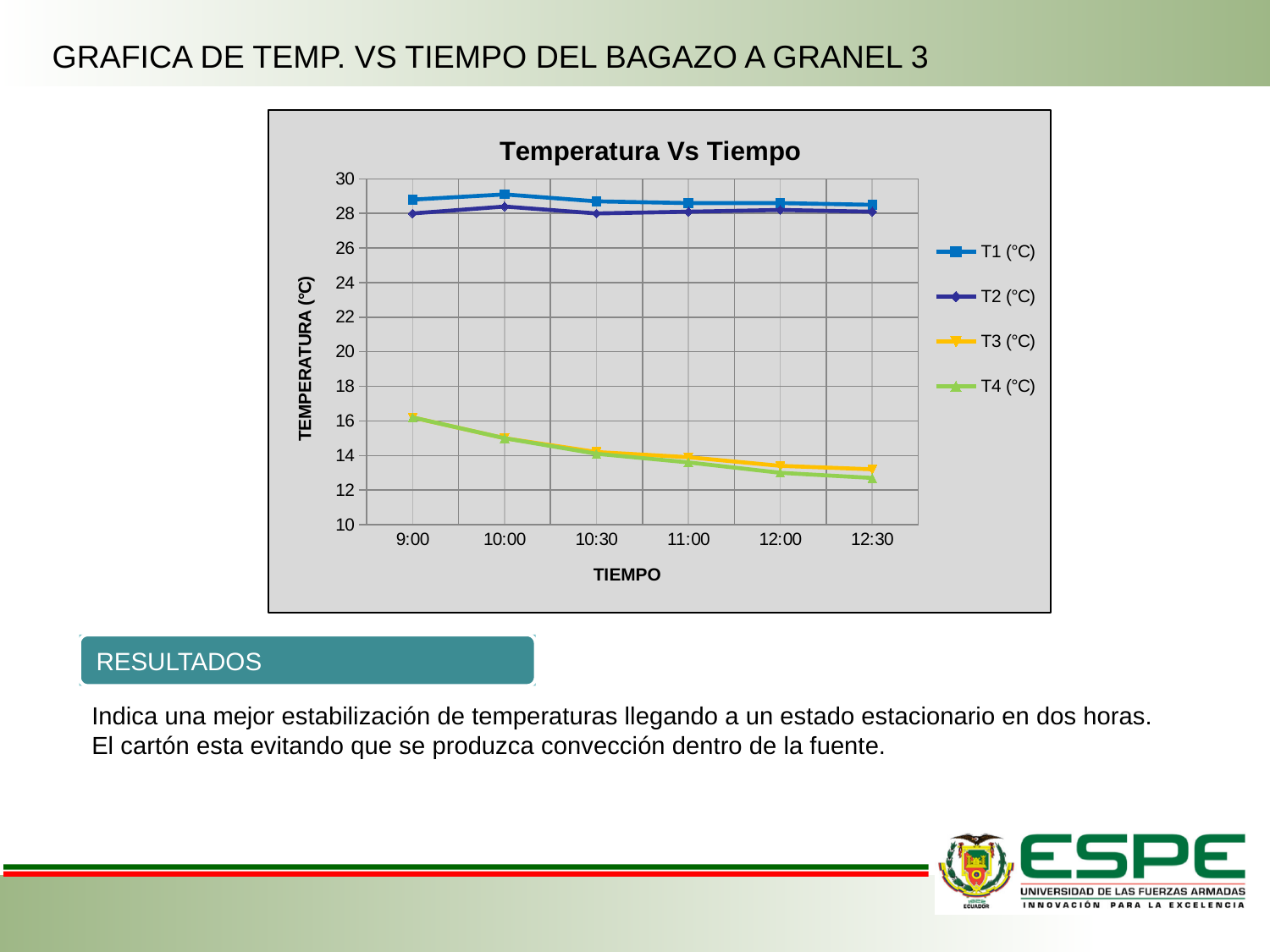
Which series has the lowest value at 12:30? T4 (°C) Is the value for T1 (°C) at 10:00 greater or less than 28? greater How many time points are plotted along the x axis? 6 What kind of chart is shown on the slide? Line chart What is the label of the x axis? TIEMPO Which series has the highest value at 12:30? T1 (°C) How many series does the legend list? 4 Is the value for T3 (°C) at 10:00 greater or less than 16? less What is the title of the chart? Temperatura Vs Tiempo Is the value for T4 (°C) at 12:30 greater or less than 14? less Do the values for T4 (°C) rise or fall from 9:00 to 12:30? fall